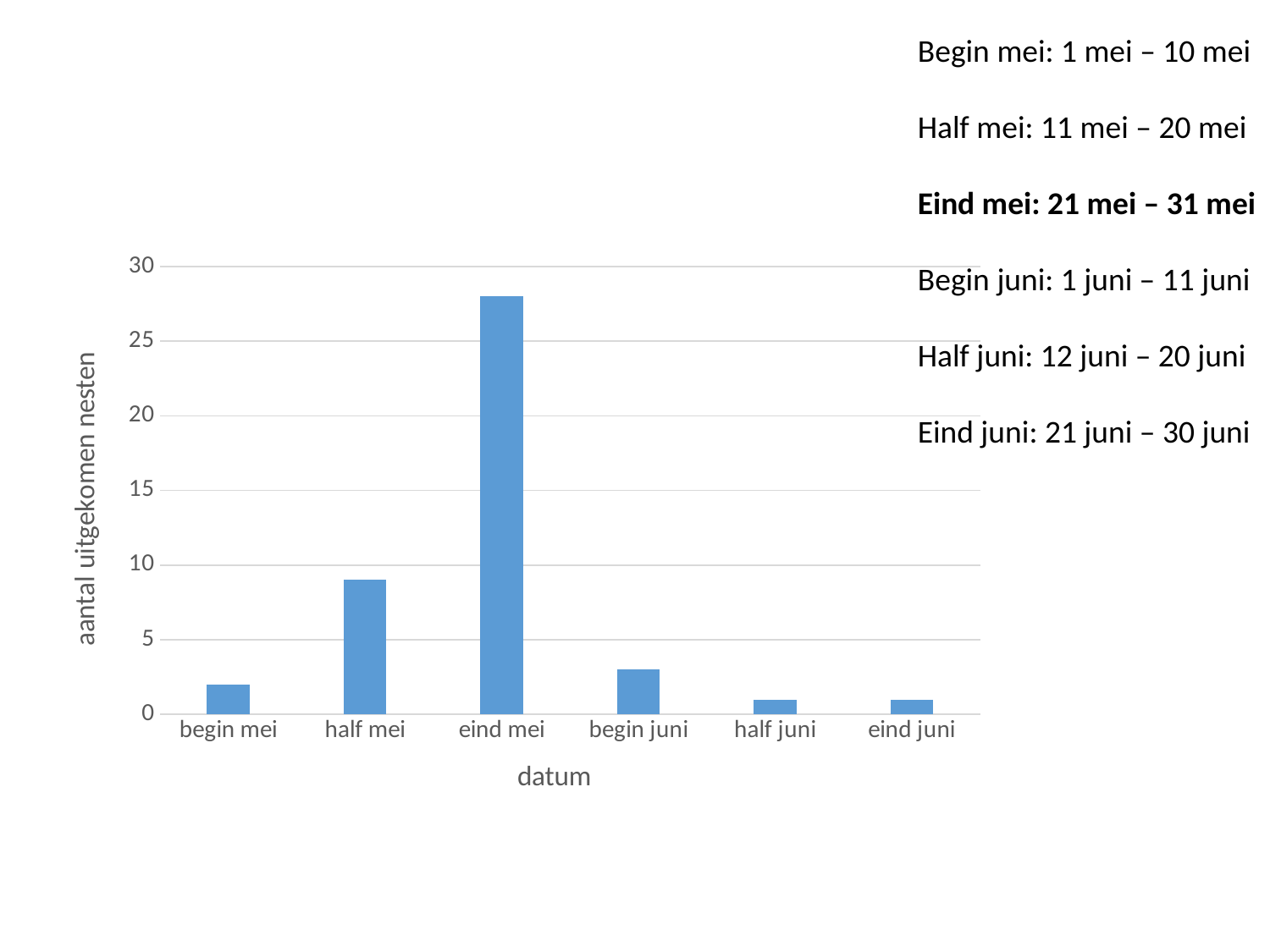
Is the value for eind mei greater or less than 25? greater Is the value for half mei greater or less than 10? less Which is larger, the value for begin mei or the value for eind mei? eind mei Which is larger, the value for half mei or the value for begin juni? half mei Is the value for begin juni greater or less than 5? less Do the values rise or fall from eind mei to eind juni? fall What is the label of the y axis? aantal uitgekomen nesten What is the label of the x axis? datum Which category has the highest number of hatched nests (aantal uitgekomen nesten)? eind mei How many categories are shown on the x axis of the chart? 6 What kind of chart is shown on the slide? bar chart